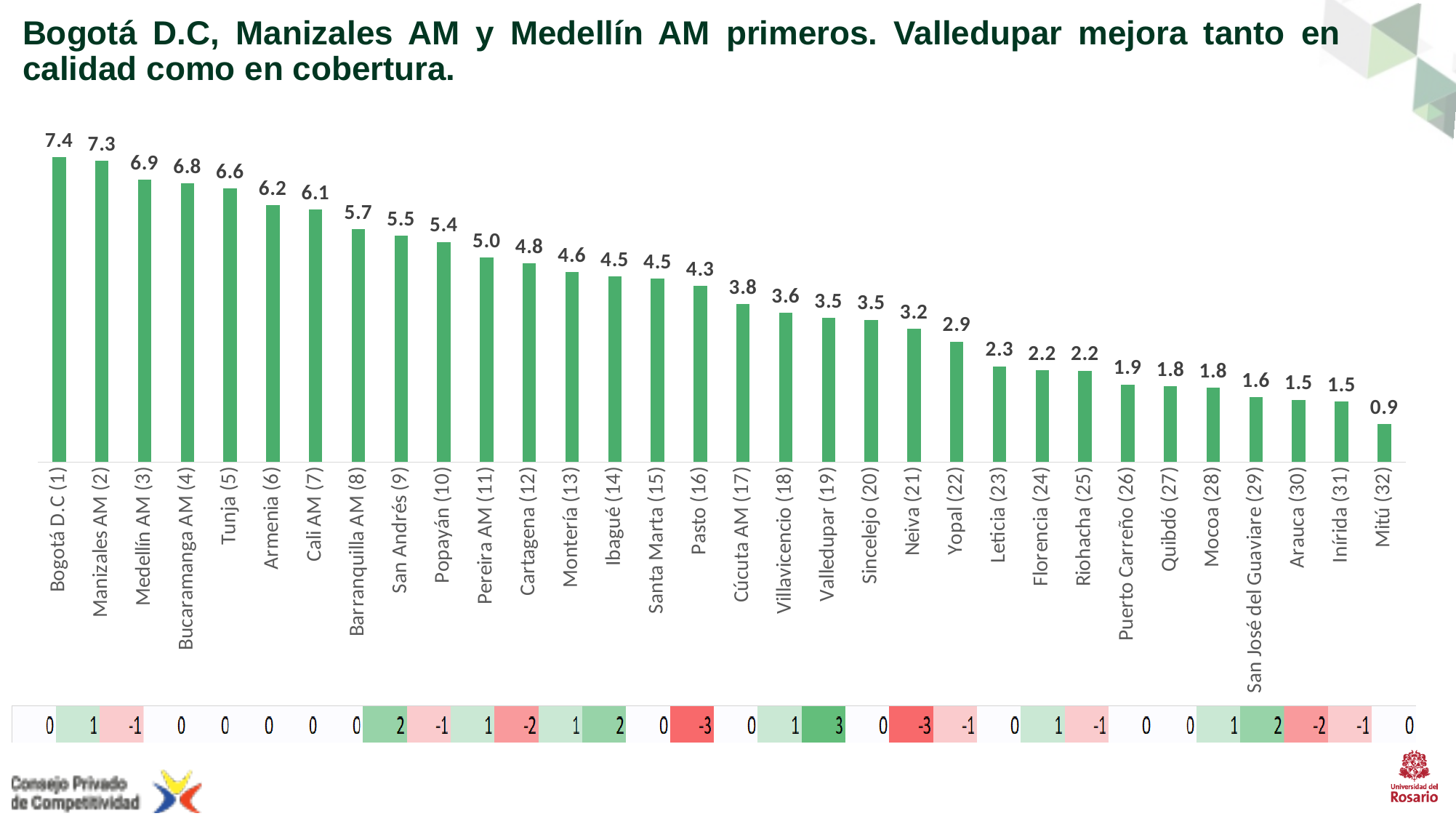
What is the value for Mitú? 0.9 Which city has the lowest value? Mitú What is the difference between the values for Tunja and Cali AM? 0.5 What is the value for Bogotá D.C? 7.4 What is the value for Pereira AM? 5.0 Which has a larger value, Cartagena or Pasto? Cartagena What is the value for Valledupar? 3.5 What kind of chart is shown on the slide? Bar chart Do the values rise or fall from left to right along the x axis? Fall What is the difference between the values for Bogotá D.C and Mitú? 6.5 Which city has the highest value? Bogotá D.C How many cities are shown in the chart? 32